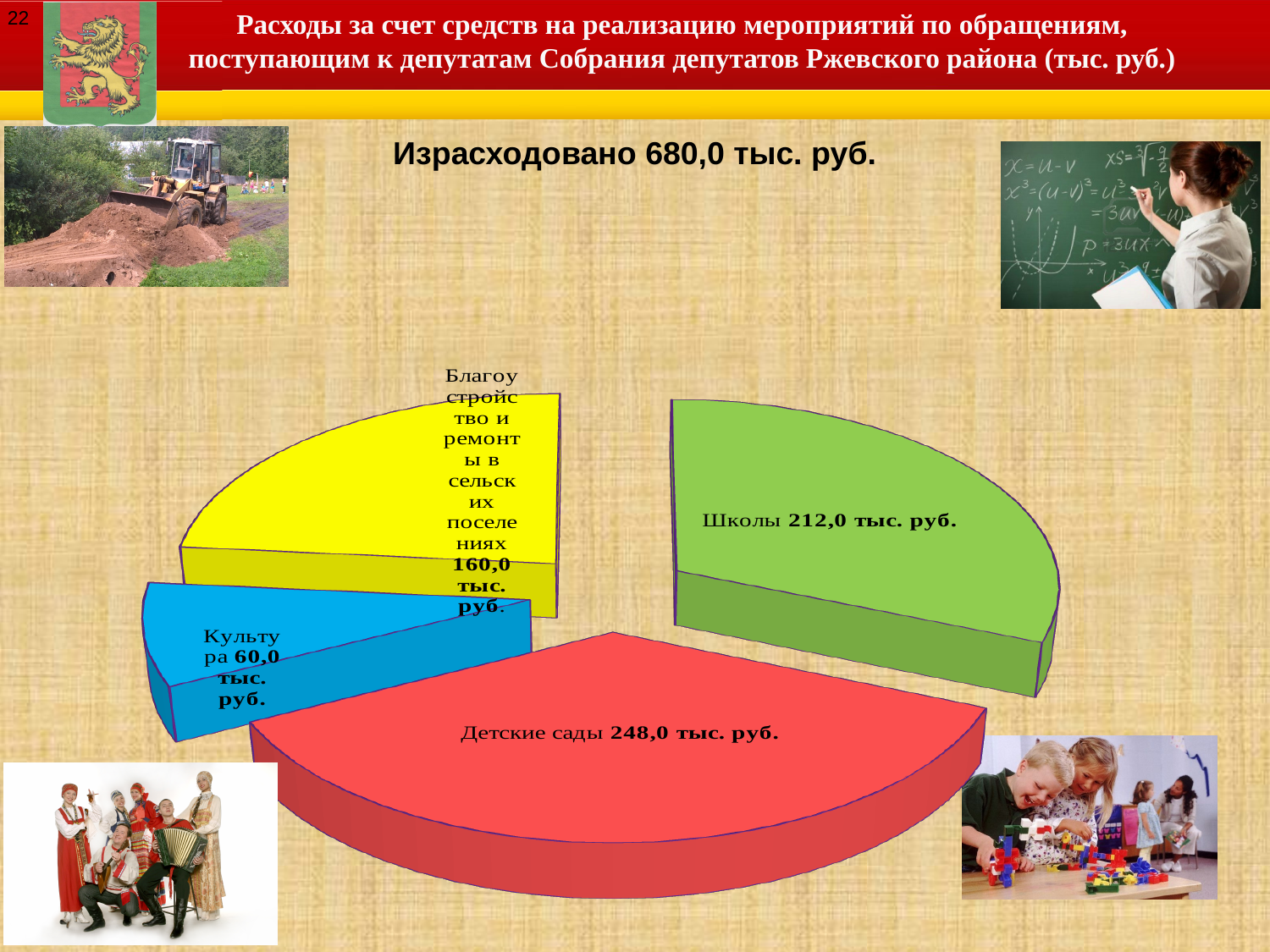
What is the value for Детские сады? 248,0 тыс. руб. Which category has the largest slice of the pie? Детские сады How many slices does the pie chart have? 4 What is the difference between the values for Детские сады and Школы? 36,0 тыс. руб. Which is larger, the value for Школы or the value for Благоустройство и ремонты в сельских поселениях? Школы What is the value for Благоустройство и ремонты в сельских поселениях? 160,0 тыс. руб. What colour is the slice for Детские сады? Red What kind of chart is shown on the slide? Pie chart What is the value for Культура? 60,0 тыс. руб. What is the total amount spent according to the slide? 680,0 тыс. руб. Which category has the smallest slice of the pie? Культура What is the value for Школы? 212,0 тыс. руб.